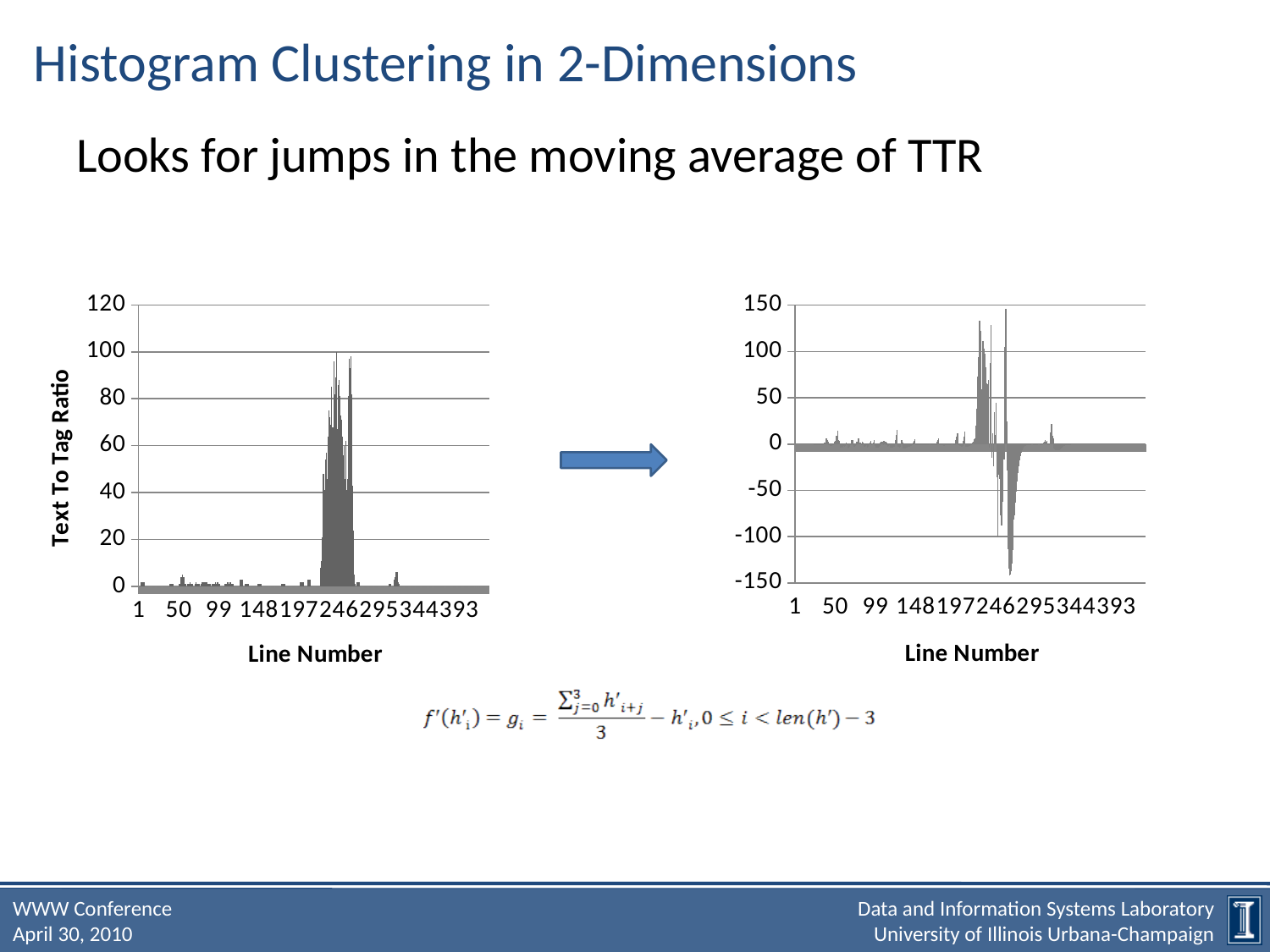
On the right chart, is the lowest plotted value greater or less than -100? less On the left chart, is the highest plotted value greater or less than 120? less What kind of chart is the left chart on the slide? bar chart How many tick labels are shown on the x axis of the left chart? 9 On the left chart, what is the label of the y axis? Text To Tag Ratio On the right chart, is the value at line number 50 greater or less than 50? less What kind of chart is the right chart on the slide? bar chart On the left chart, which is larger: the peak near line number 246 or the small bump near line number 344? the peak near line number 246 On the right chart, what is the label of the x axis? Line Number